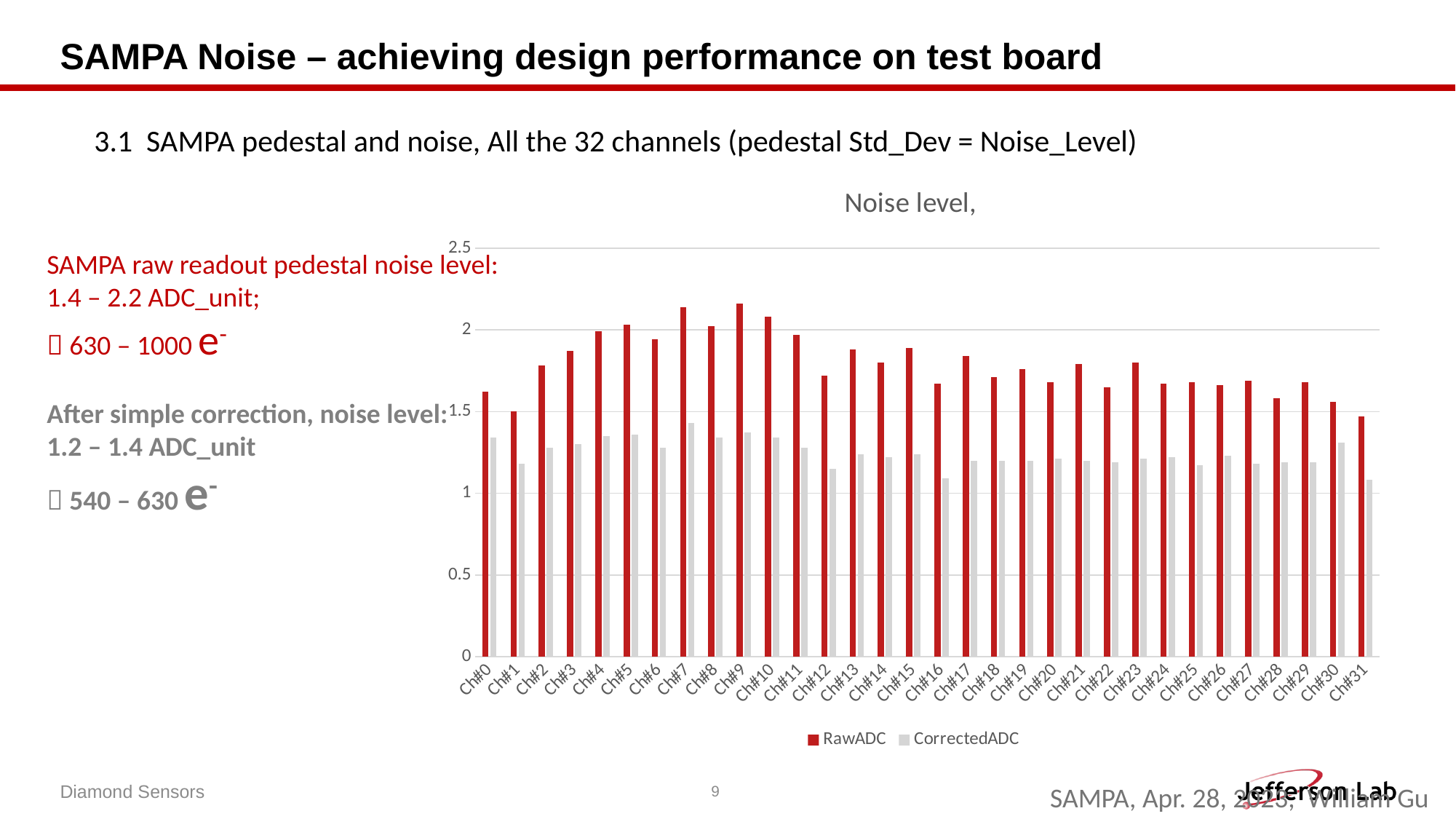
Which series is drawn in red? RawADC Is the RawADC value for Ch#0 greater or less than 1.5? greater What kind of chart is shown on the slide? bar chart Is the RawADC value for Ch#12 greater or less than 2? less How many series does the legend list? 2 How many channels (categories) are plotted on the x axis? 32 Is the RawADC value for Ch#9 greater or less than 2? greater For Ch#7, which is larger, the RawADC value or the CorrectedADC value? RawADC What are the two series named in the legend? RawADC and CorrectedADC Which channel has the highest CorrectedADC value? Ch#7 Which is larger, the RawADC value for Ch#9 or for Ch#1? Ch#9